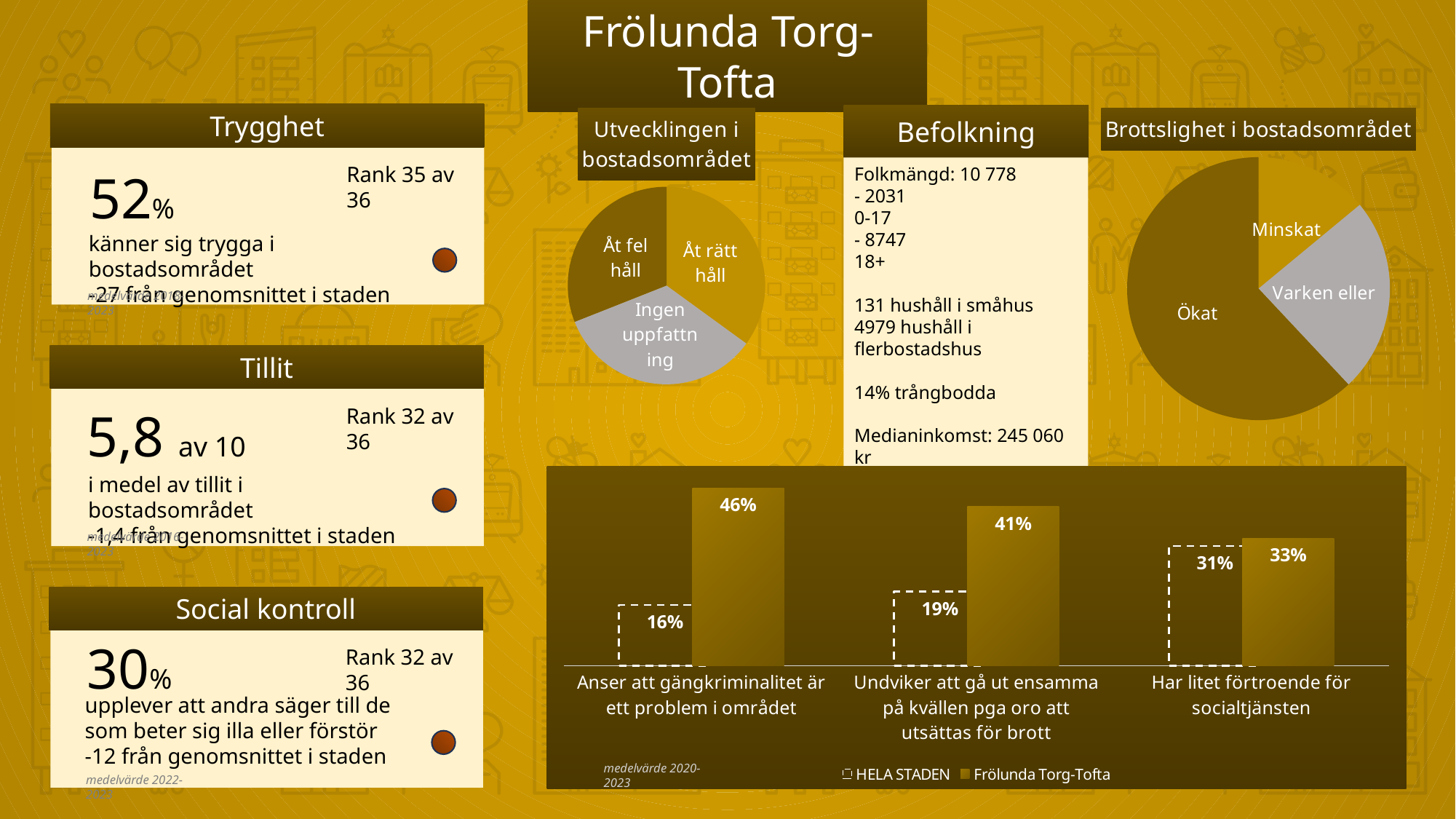
In the bar chart at the bottom, which is larger for 'Har litet förtroende för socialtjänsten': HELA STADEN or Frölunda Torg-Tofta? Frölunda Torg-Tofta In the bar chart at the bottom, which category has the lowest value for HELA STADEN? Anser att gängkriminalitet är ett problem i området How many categories are shown in the bar chart at the bottom? 3 In the bar chart at the bottom, what is the difference between Frölunda Torg-Tofta and HELA STADEN for 'Anser att gängkriminalitet är ett problem i området'? 30% How many slices does the pie chart 'Utvecklingen i bostadsområdet' have? 3 In the bar chart at the bottom, what is the value for HELA STADEN for 'Undviker att gå ut ensamma på kvällen pga oro att utsättas för brott'? 19% In the bar chart at the bottom, what is the value for Frölunda Torg-Tofta for 'Har litet förtroende för socialtjänsten'? 33% In the bar chart at the bottom, what is the difference between Frölunda Torg-Tofta and HELA STADEN for 'Undviker att gå ut ensamma på kvällen pga oro att utsättas för brott'? 22% In the pie chart 'Brottslighet i bostadsområdet', which slice is the largest? Ökat How many series does the legend of the bar chart at the bottom list? 2 In the bar chart at the bottom, which category has the highest value for Frölunda Torg-Tofta? Anser att gängkriminalitet är ett problem i området In the bar chart at the bottom, what is the value for Frölunda Torg-Tofta for 'Anser att gängkriminalitet är ett problem i området'? 46%